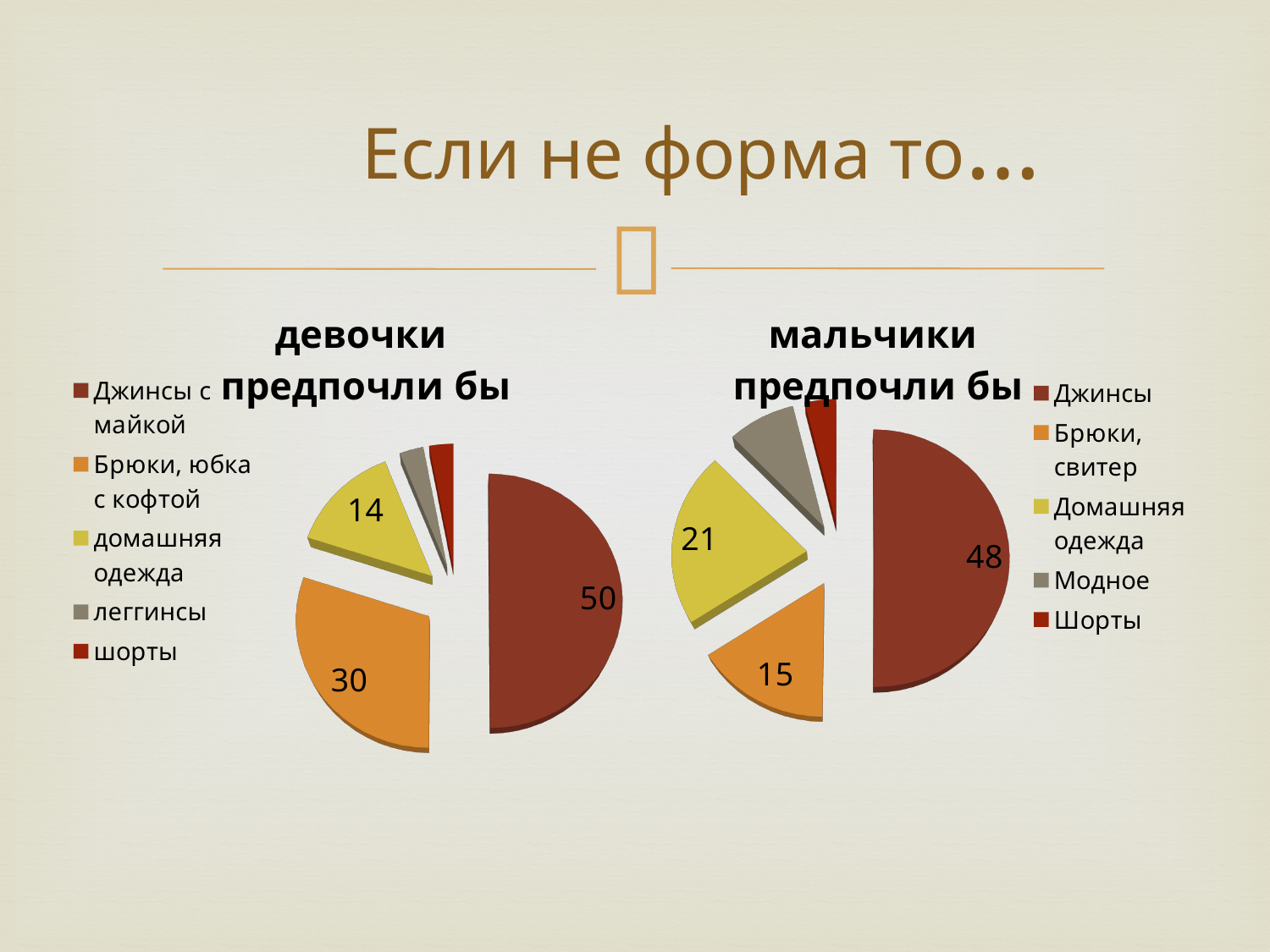
In the 'девочки предпочли бы' chart, what is the value for 'Брюки, юбка с кофтой'? 30 In the 'девочки предпочли бы' chart, what is the value for 'домашняя одежда'? 14 In the 'мальчики предпочли бы' chart, what is the value for 'Брюки, свитер'? 15 How many categories does the legend of the 'девочки предпочли бы' chart list? 5 In the 'мальчики предпочли бы' chart, what is the value for 'Джинсы'? 48 In the 'девочки предпочли бы' chart, which category has the largest slice? Джинсы с майкой In the 'мальчики предпочли бы' chart, which category has the largest slice? Джинсы In the 'мальчики предпочли бы' chart, what is the value for 'Домашняя одежда'? 21 In the 'девочки предпочли бы' chart, what is the difference between 'Джинсы с майкой' and 'Брюки, юбка с кофтой'? 20 In the 'мальчики предпочли бы' chart, which is larger: 'Домашняя одежда' or 'Брюки, свитер'? Домашняя одежда In the 'мальчики предпочли бы' chart, what is the difference between 'Джинсы' and 'Домашняя одежда'? 27 In the 'девочки предпочли бы' chart, what is the value for 'Джинсы с майкой'? 50